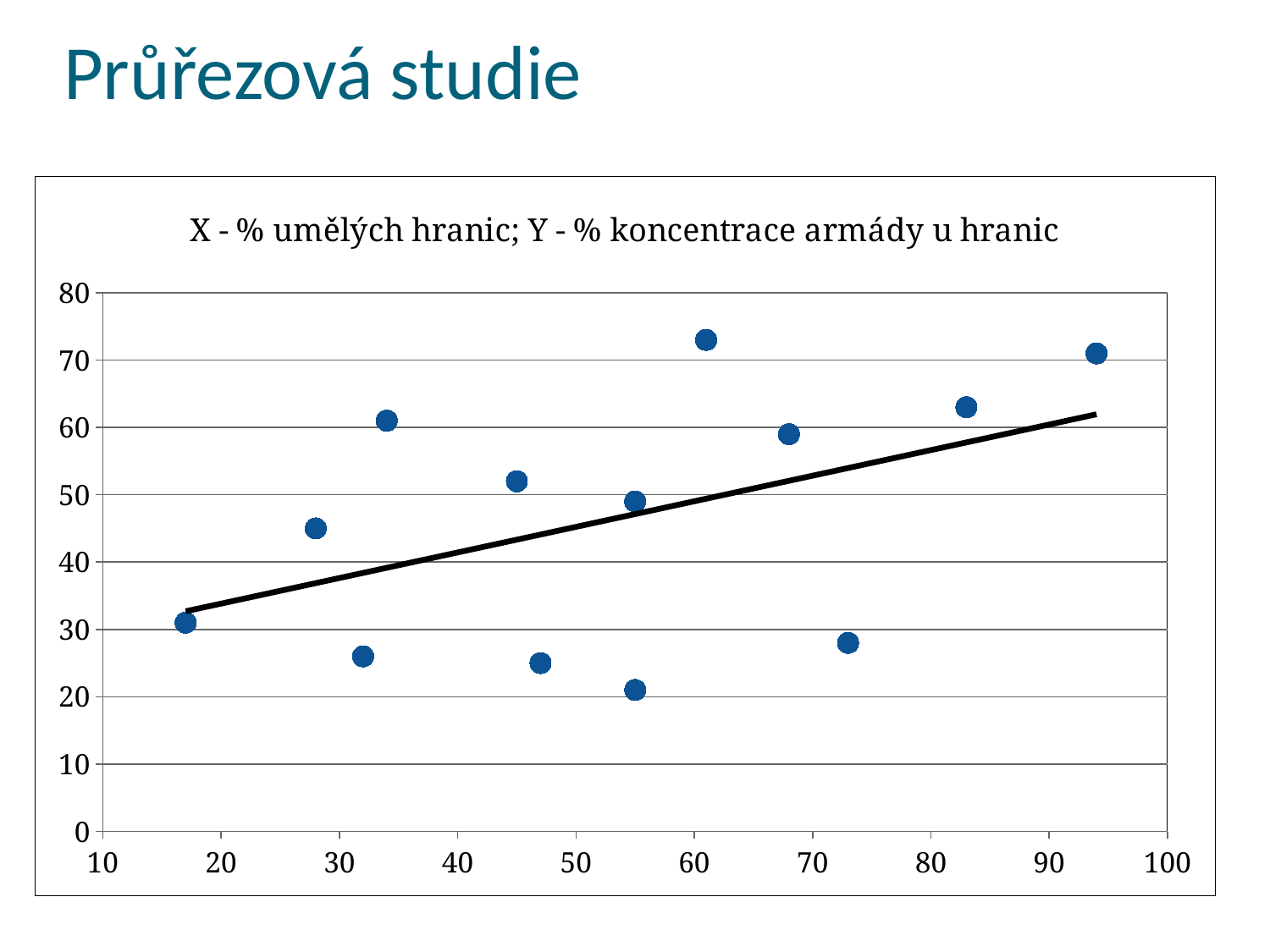
Is the y value of the highest plotted point greater or less than 70? greater Is the y value of the point near x = 34 greater or less than 50? greater What is the highest value shown on the y axis of the chart? 80 Does the trend line on the chart rise or fall as the x value increases? rises Is the y value of the point with the smallest x value (near x = 17) greater or less than 40? less What is the title of the chart? X - % umělých hranic; Y - % koncentrace armády u hranic Which has the higher y value: the point near x = 61 or the point near x = 68? the point near x = 61 How many data points are plotted on the chart? 13 What kind of chart is shown on the slide? scatter chart